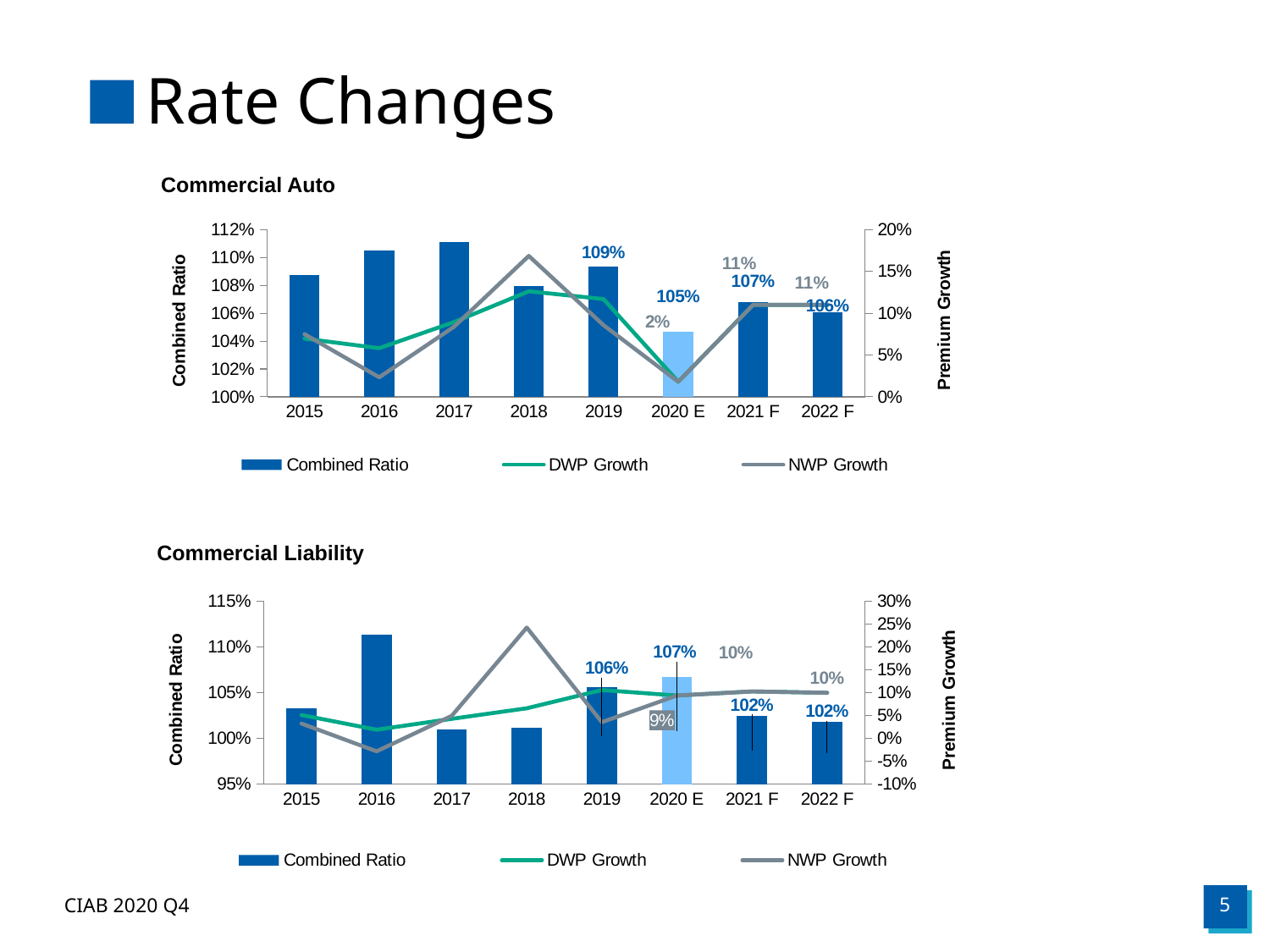
In the Commercial Liability chart, is the Combined Ratio bar for 2017 greater or less than 105%? less How many years are shown on the x axis of the Commercial Liability chart? 8 In the Commercial Auto chart, what is the difference between the Combined Ratio for 2019 and for 2020 E? 4% In the Commercial Auto chart, what is the Combined Ratio for 2019? 109% In the Commercial Auto chart, what is the Combined Ratio for 2021 F? 107% In the Commercial Liability chart, which year has the highest Combined Ratio bar? 2016 In the Commercial Liability chart, what is the Combined Ratio for 2021 F? 102% What kind of chart is the Commercial Auto chart? A combined bar and line chart How many series does the legend of the Commercial Auto chart list? 3 In the Commercial Auto chart, is the Combined Ratio bar for 2016 greater or less than 108%? greater In the Commercial Liability chart, which is larger, the Combined Ratio for 2019 or for 2020 E? 2020 E In the Commercial Auto chart, which year has the highest Combined Ratio bar? 2017